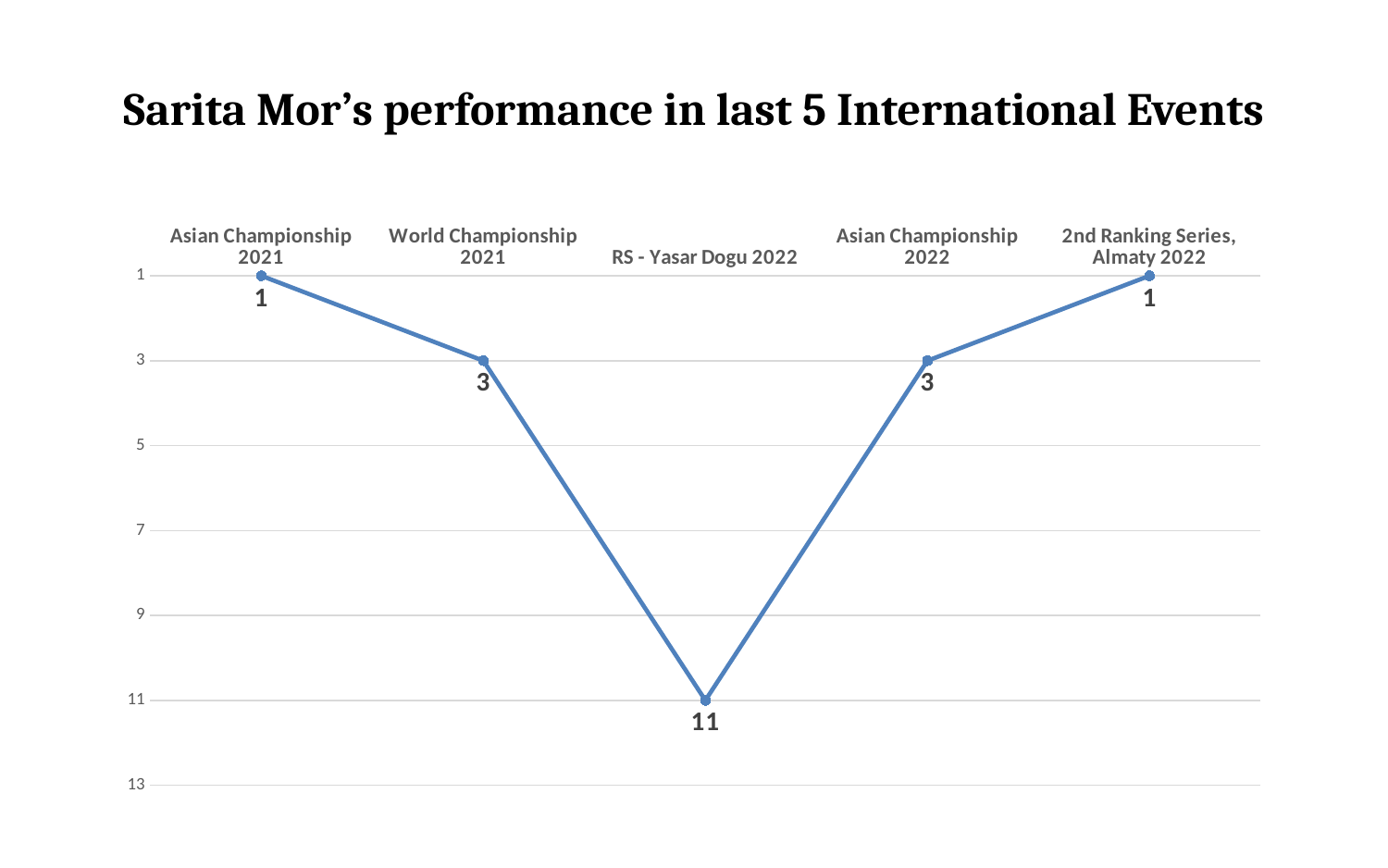
Which event has the highest plotted value? RS - Yasar Dogu 2022 Which has the larger plotted value, World Championship 2021 or RS - Yasar Dogu 2022? RS - Yasar Dogu 2022 How many events are plotted on the chart? 5 Is the value for RS - Yasar Dogu 2022 greater or less than 9? greater What is the value plotted for World Championship 2021? 3 What is the value plotted for RS - Yasar Dogu 2022? 11 What is the value plotted for Asian Championship 2021? 1 What is the value plotted for 2nd Ranking Series, Almaty 2022? 1 What is the value plotted for Asian Championship 2022? 3 What kind of chart is shown on the slide? Line chart What is the title of the chart? Sarita Mor's performance in last 5 International Events What is the difference between the values for RS - Yasar Dogu 2022 and Asian Championship 2022? 8